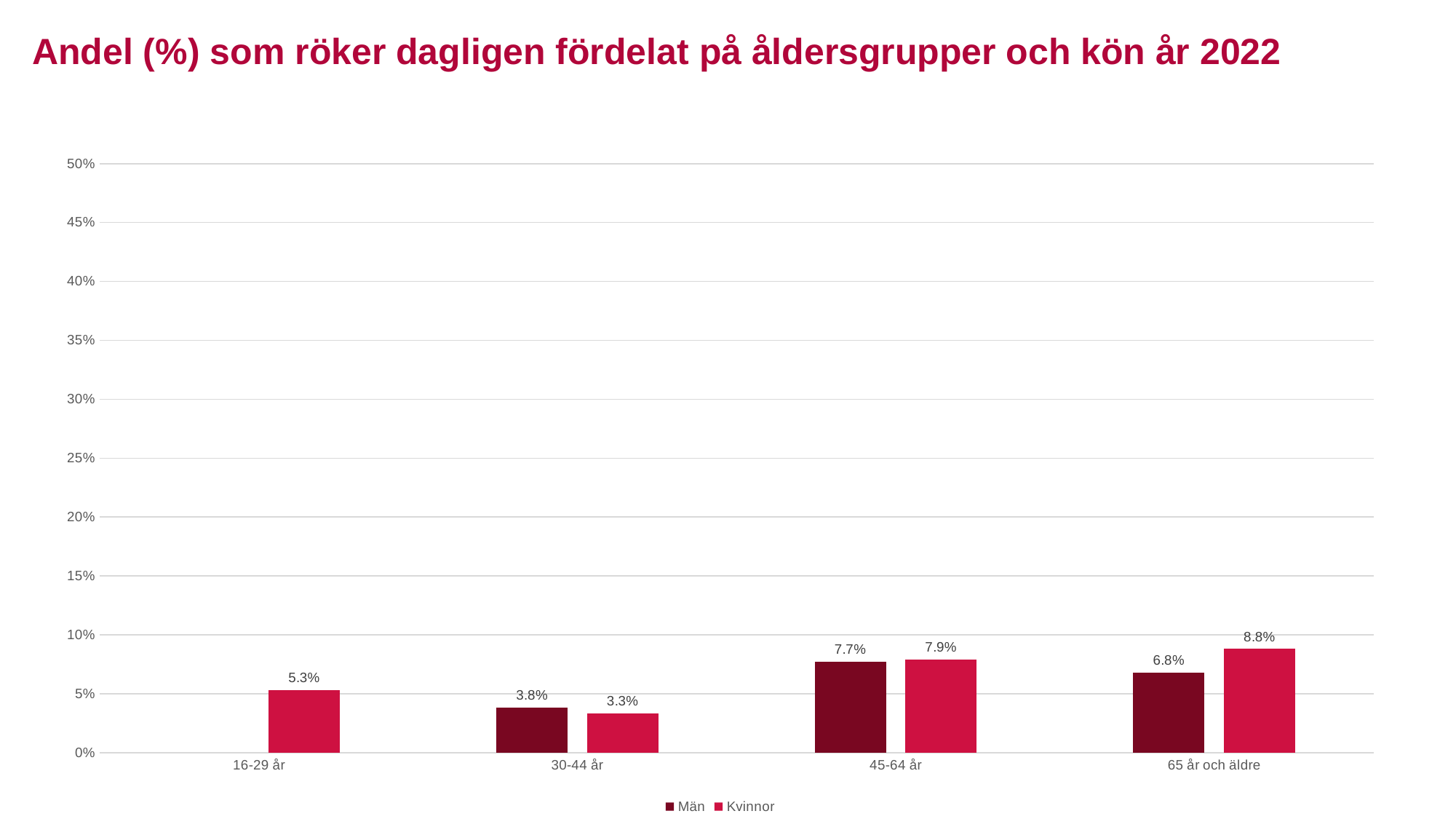
Which age group has the highest value for Kvinnor? 65 år och äldre What is the difference between the Kvinnor and Män values in the 65 år och äldre age group? 2.0% Which age group has the lowest value for Kvinnor? 30-44 år How many age groups are shown on the x axis? 4 What is the value for Kvinnor in the 16-29 år age group? 5.3% What is the value for Män in the 65 år och äldre age group? 6.8% Is the value for Kvinnor in the 65 år och äldre age group greater or less than 10%? less What kind of chart is shown on the slide? bar chart What is the value for Kvinnor in the 45-64 år age group? 7.9% Which is larger in the 30-44 år age group, the value for Män or for Kvinnor? Män How many series does the legend list? 2 What is the value for Män in the 30-44 år age group? 3.8%